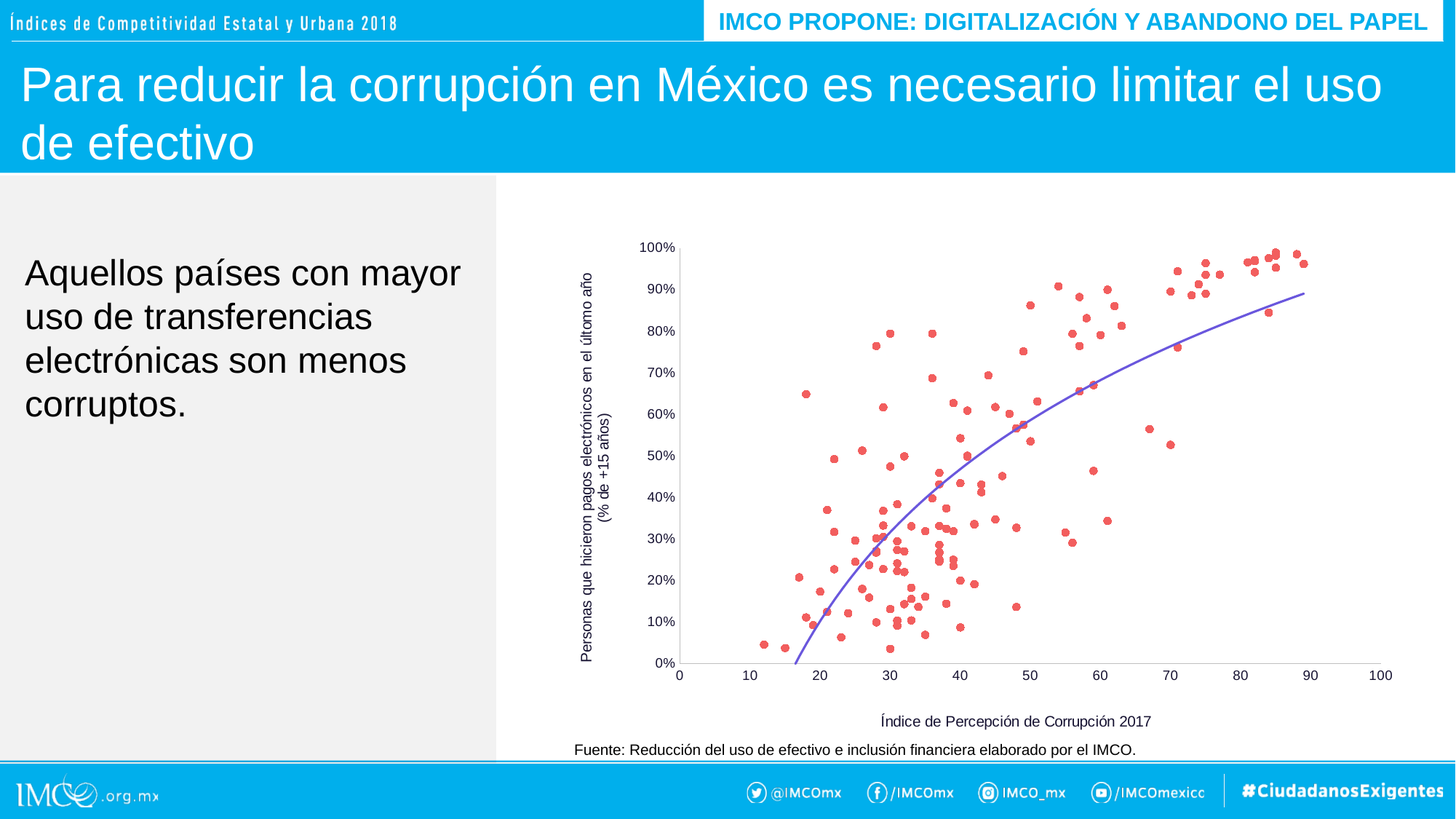
What is the highest value shown on the y axis of the chart? 100% Does the fitted trend line on the chart slope upward or downward from left to right? Upward What kind of chart is shown on the slide? Scatter chart Is the lowest plotted point on the chart greater or less than 10% on the y axis? less What is the label of the x axis of the chart? Índice de Percepción de Corrupción 2017 Is the leftmost plotted point on the chart greater or less than 20 on the x axis? less Is the highest plotted point on the chart greater or less than 90% on the y axis? greater Do the plotted values generally rise or fall as the Índice de Percepción de Corrupción 2017 increases along the x axis? Rise